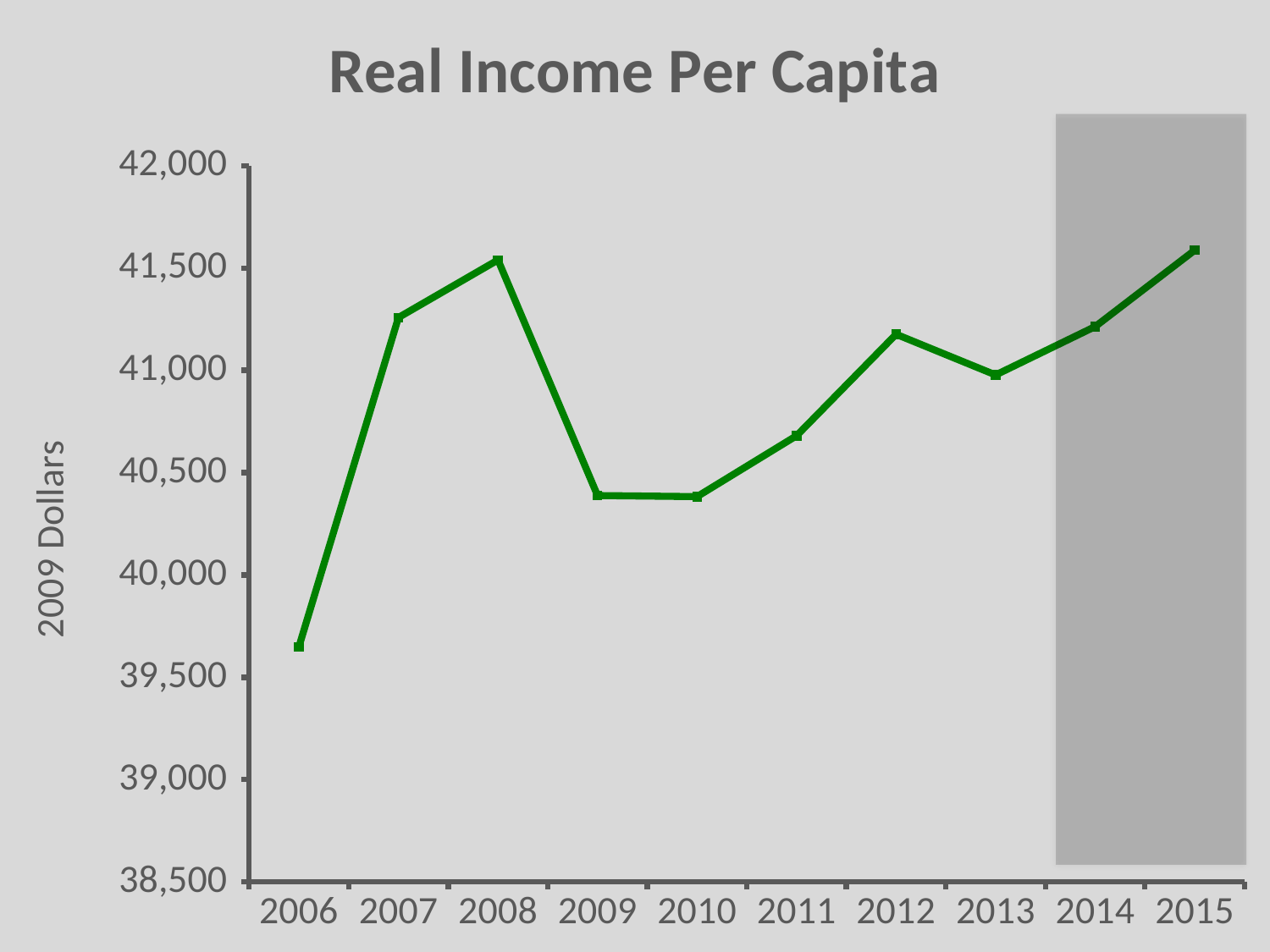
What is the label on the vertical axis? 2009 Dollars Which year has the higher value, 2007 or 2009? 2007 Is the value for 2006 greater or less than 40,000? less Which year has the lowest real income per capita? 2006 Does the value rise or fall from 2008 to 2009? fall Does the value rise or fall from 2013 to 2015? rise Is the value for 2009 greater or less than 40,500? less How many years are plotted on the x axis? 10 Is the value for 2012 greater or less than 41,000? greater What kind of chart is shown on the slide? line chart What is the title of the chart? Real Income Per Capita